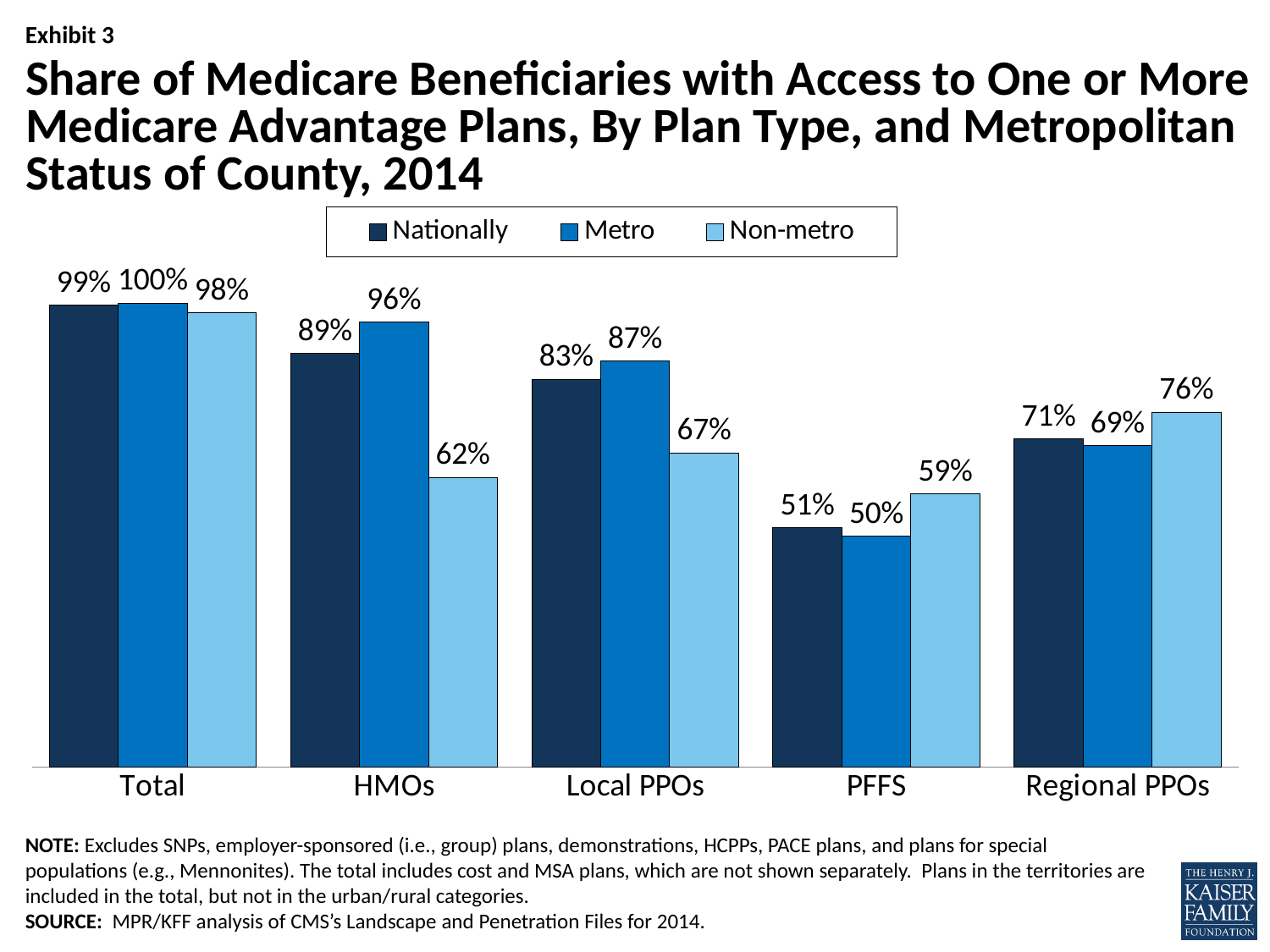
What is the Nationally value for Regional PPOs? 71% Which plan type has the lowest Nationally value? PFFS Which series is shown in the lightest blue colour? Non-metro Which is larger for Regional PPOs, the Metro value or the Non-metro value? Non-metro What is the Non-metro value for PFFS? 59% What is the difference between the Metro and Non-metro values for HMOs? 34 percentage points Which category has the highest Metro value? Total How many plan type categories are shown on the x axis? 5 How many series does the legend list? 3 What is the difference between the Nationally values for Local PPOs and PFFS? 32 percentage points What kind of chart is shown on the slide? Bar chart What is the Metro value for HMOs? 96%